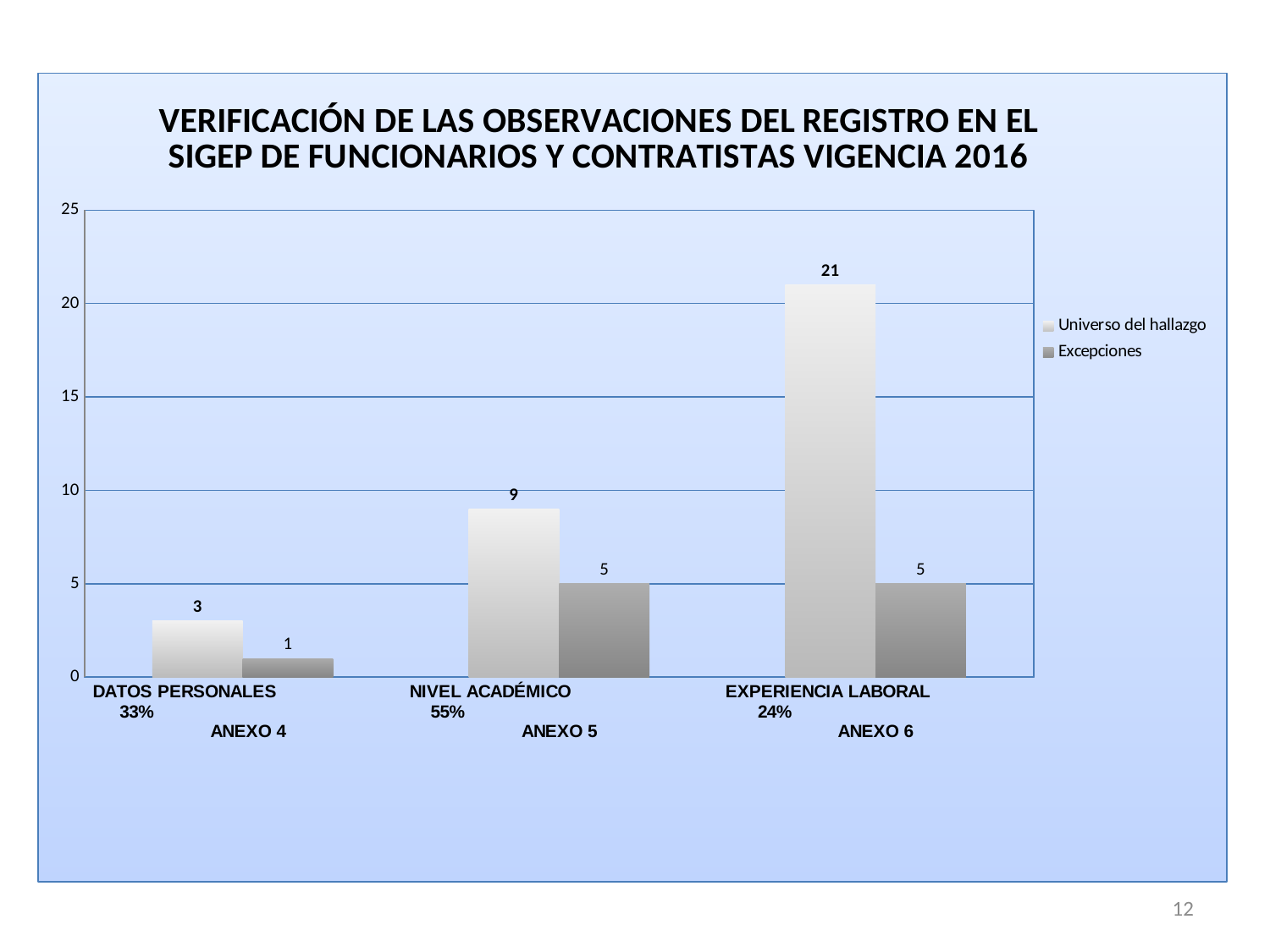
Is the Universo del hallazgo value for EXPERIENCIA LABORAL greater or less than 20? greater How many series does the legend list? 2 What is the value of Excepciones for DATOS PERSONALES? 1 What is the value of Universo del hallazgo for NIVEL ACADÉMICO? 9 What is the difference between Universo del hallazgo and Excepciones for EXPERIENCIA LABORAL? 16 Which category has the lowest Excepciones value? DATOS PERSONALES What is the value of Universo del hallazgo for EXPERIENCIA LABORAL? 21 What percentage is shown under NIVEL ACADÉMICO on the x axis? 55% Which category has the highest Universo del hallazgo value? EXPERIENCIA LABORAL What kind of chart is shown on the slide? bar chart How many categories are shown on the x axis? 3 Which is larger: Universo del hallazgo for NIVEL ACADÉMICO or Universo del hallazgo for DATOS PERSONALES? NIVEL ACADÉMICO